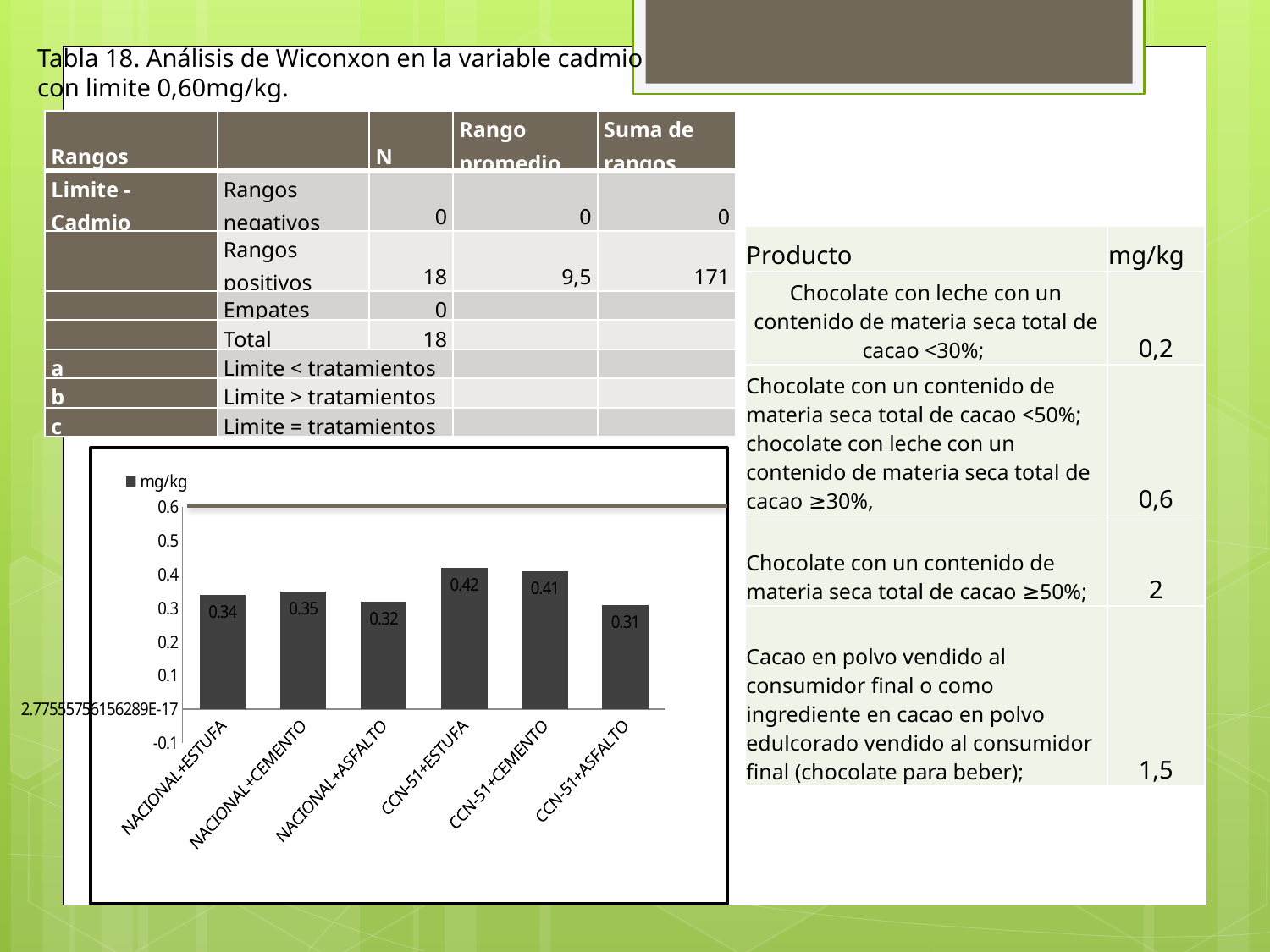
Is the value for CCN-51+CEMENTO in the bar chart greater or less than 0.3? greater What is the value for NACIONAL+ASFALTO in the bar chart? 0.32 What is the legend entry of the bar chart? mg/kg Which category has the lowest value in the bar chart? CCN-51+ASFALTO What is the value for CCN-51+ESTUFA in the bar chart? 0.42 How many categories are shown in the bar chart? 6 Which category has the highest value in the bar chart? CCN-51+ESTUFA What is the value for NACIONAL+CEMENTO in the bar chart? 0.35 What kind of chart is shown on the slide? bar chart What is the difference between the values for CCN-51+ESTUFA and CCN-51+ASFALTO in the bar chart? 0.11 How many series does the legend of the bar chart list? 1 Which is larger in the bar chart, NACIONAL+ESTUFA or CCN-51+CEMENTO? CCN-51+CEMENTO